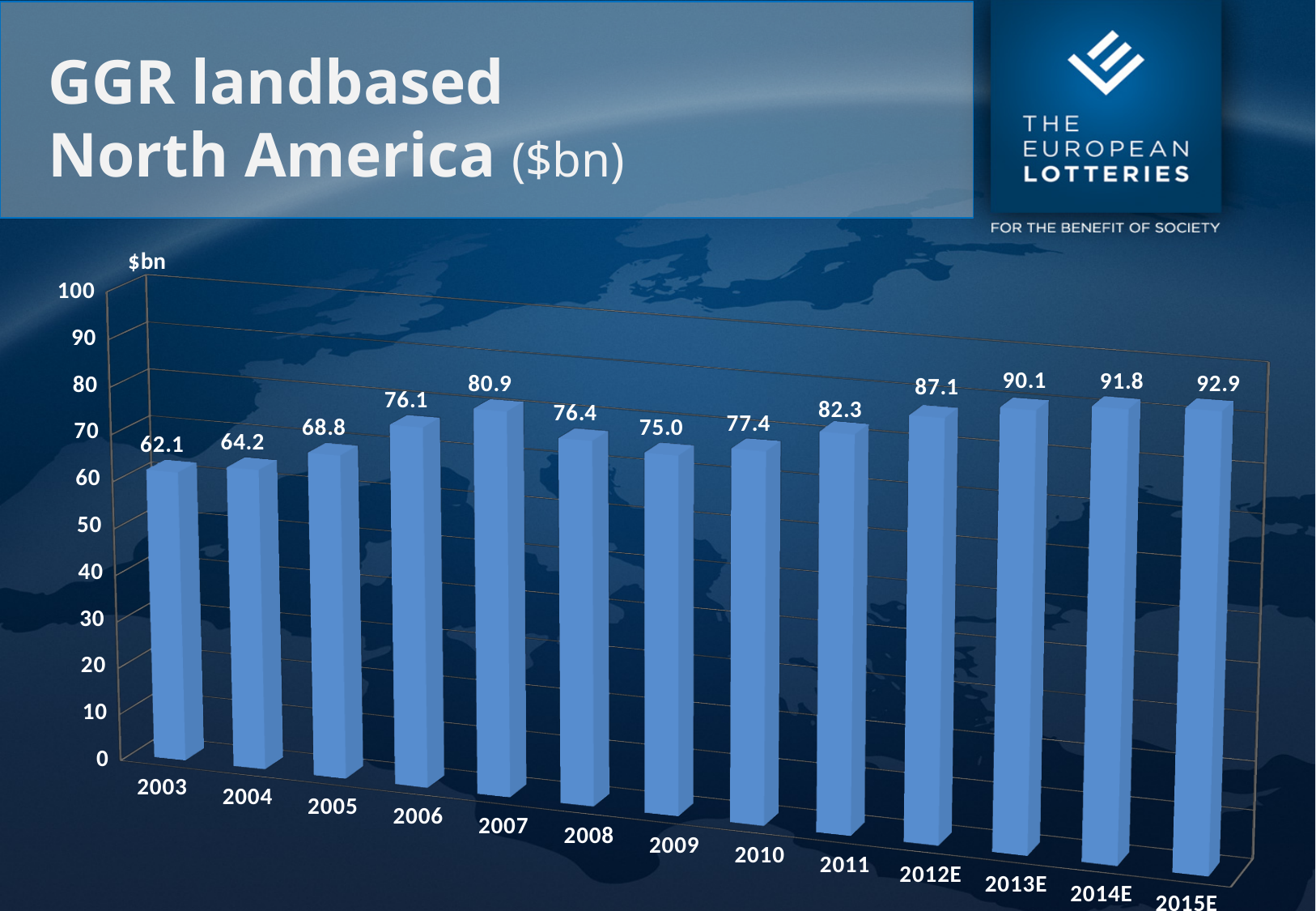
What is the value shown for 2012E? 87.1 What kind of chart is shown on the slide? bar chart What unit is shown on the y axis label? $bn Is the value for 2011 greater or less than 80? greater Which year has the lowest value? 2003 What is the difference between the values for 2007 and 2008? 4.5 What is the GGR landbased North America value for 2003? 62.1 How many years are shown on the x axis? 13 Which is larger, the value for 2007 or the value for 2009? 2007 What is the value shown for 2007? 80.9 Which year has the highest value? 2015E What is the difference between the values for 2015E and 2003? 30.8